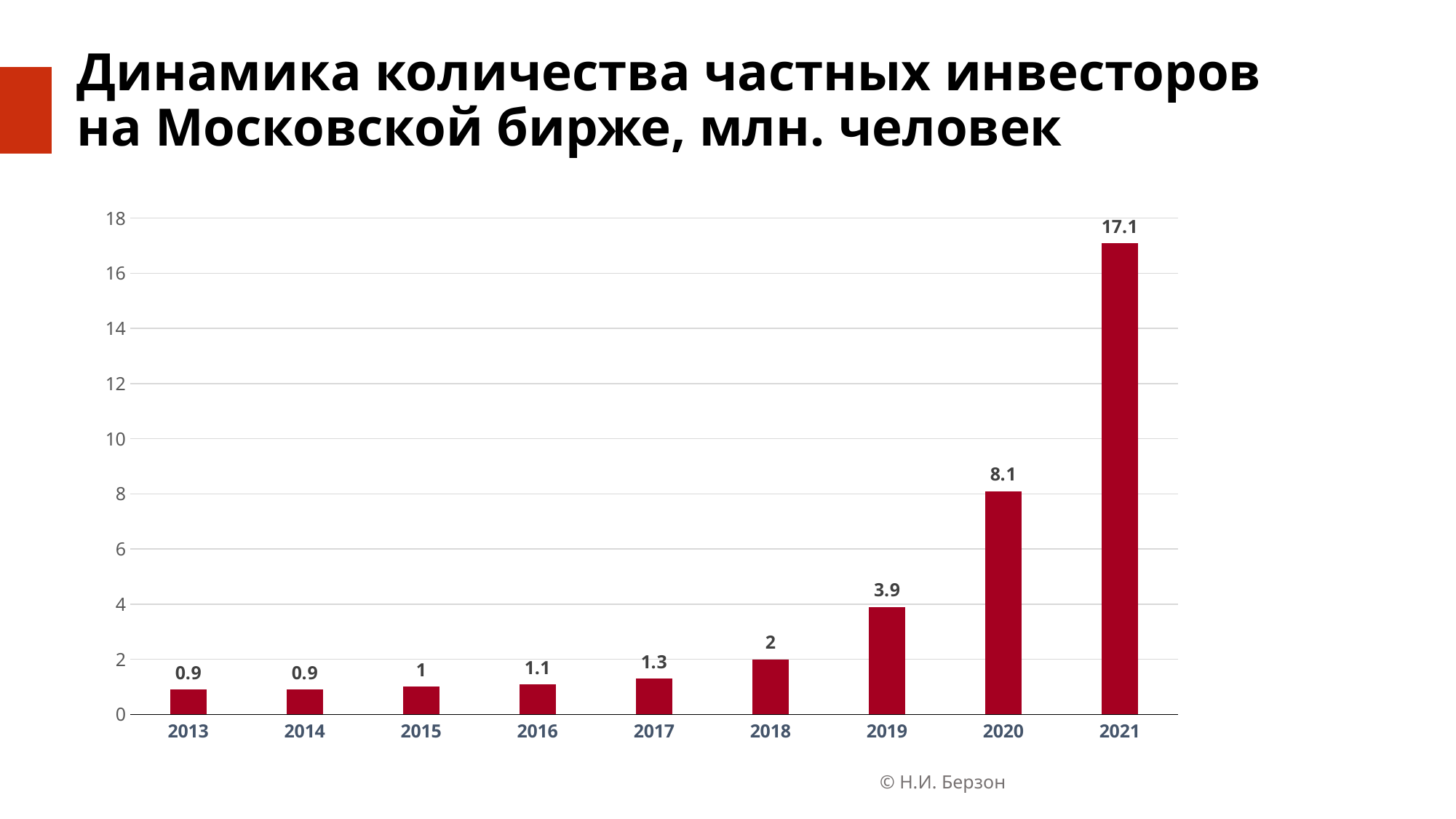
Is the value for 2020 greater or less than 6? greater What is the difference between the values for 2019 and 2018? 1.9 Which year has the highest value? 2021 What is the value for 2018? 2 What is the value for 2015? 1 How many years are shown on the x axis? 9 What is the title of the chart? Динамика количества частных инвесторов на Московской бирже, млн. человек What kind of chart is shown on the slide? bar chart What is the value for 2021? 17.1 Do the values rise or fall from 2013 to 2021? rise What is the difference between the values for 2021 and 2020? 9 Which is larger, the value for 2020 or the value for 2019? 2020